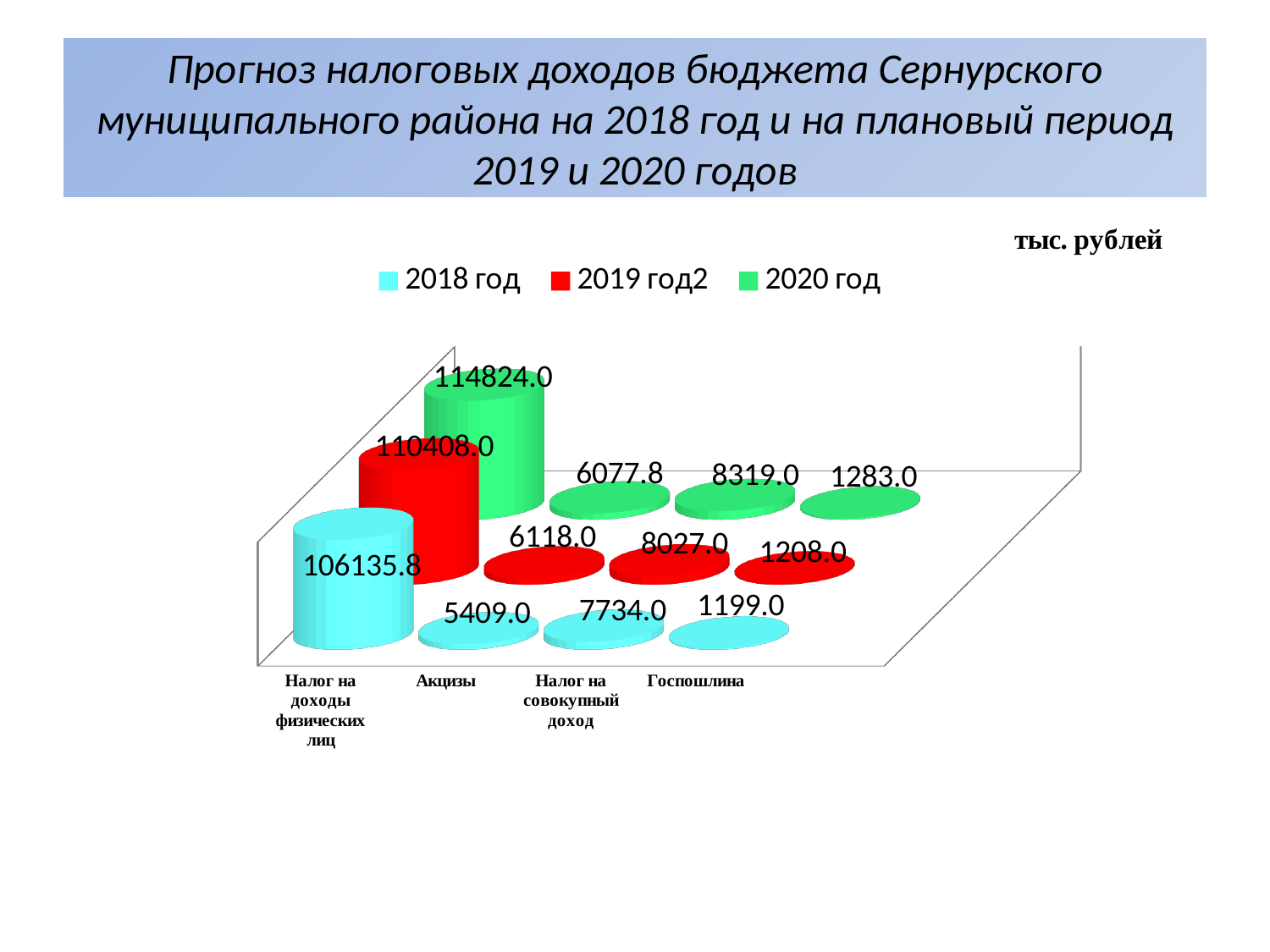
What is the value for Налог на доходы физических лиц in the 2018 год series? 106135.8 Which category has the highest value in the 2020 год series? Налог на доходы физических лиц How many series does the legend list? 3 What kind of chart is shown on the slide? Bar chart What unit is indicated for the values on the chart? тыс. рублей Which is larger for Акцизы: the 2019 год2 value or the 2020 год value? 2019 год2 Which category has the lowest value in the 2018 год series? Госпошлина What is the value for Налог на совокупный доход in the 2018 год series? 7734.0 How many categories are shown on the x axis? 4 What is the difference between the 2020 год and 2018 год values for Налог на доходы физических лиц? 8688.2 What is the value for Госпошлина in the 2019 год2 series? 1208.0 What is the value for Акцизы in the 2020 год series? 6077.8